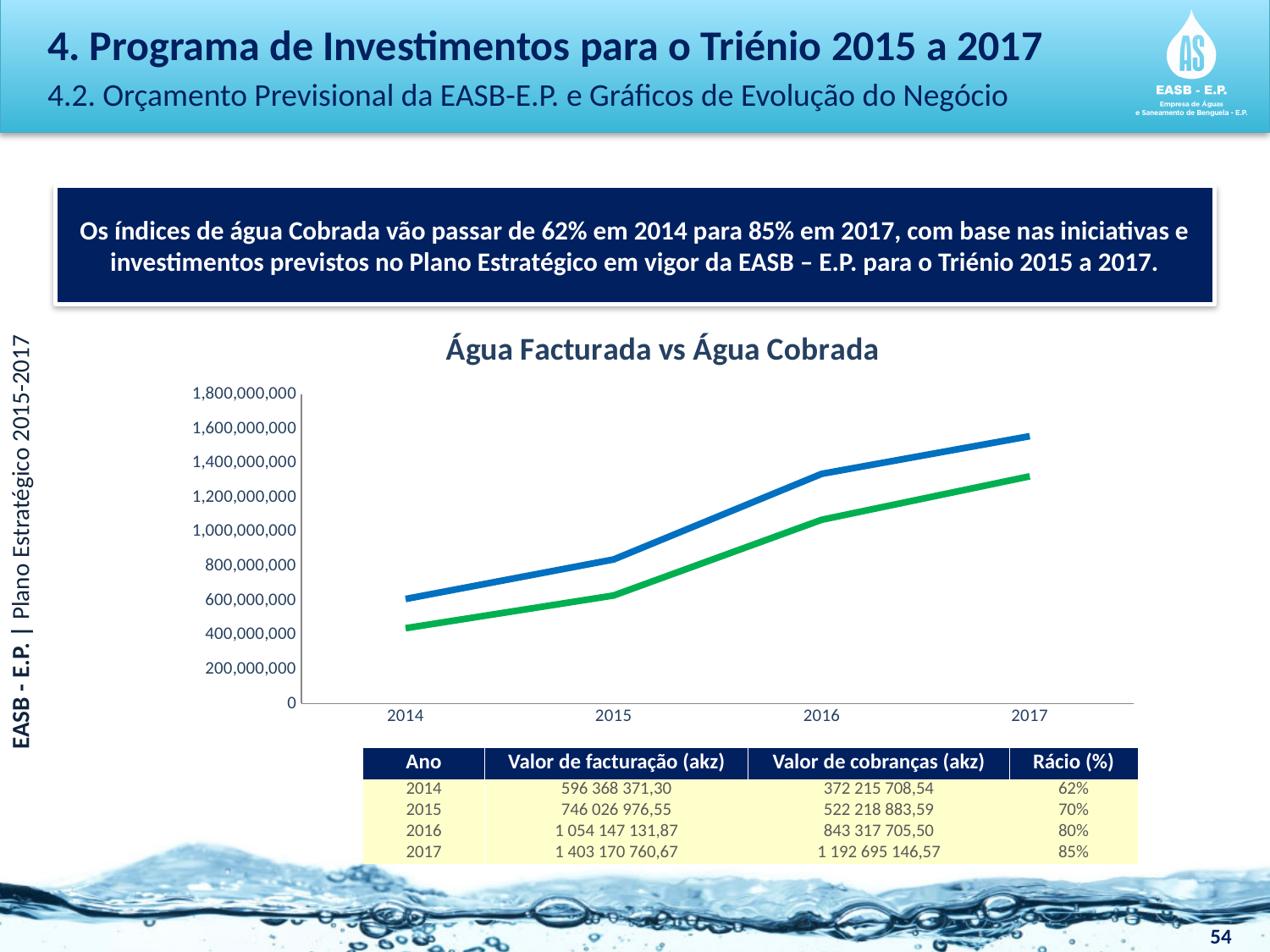
What is the title of the chart? Água Facturada vs Água Cobrada Do the values of the green line rise or fall from 2014 to 2017? rise In which year does the green line have its lowest value? 2014 What type of chart is shown on the slide? line chart Is the value of the green line in 2014 greater or less than 600,000,000? less How many lines are plotted in the chart? 2 How many years are shown on the x axis of the chart? 4 In which year does the blue line reach its highest value? 2017 Is the value of the blue line in 2017 greater or less than 1,400,000,000? greater Is the value of the blue line in 2016 greater or less than 1,200,000,000? greater Do the values of the blue line rise or fall from 2014 to 2017? rise In 2017, which line has the higher value, the blue line or the green line? blue line